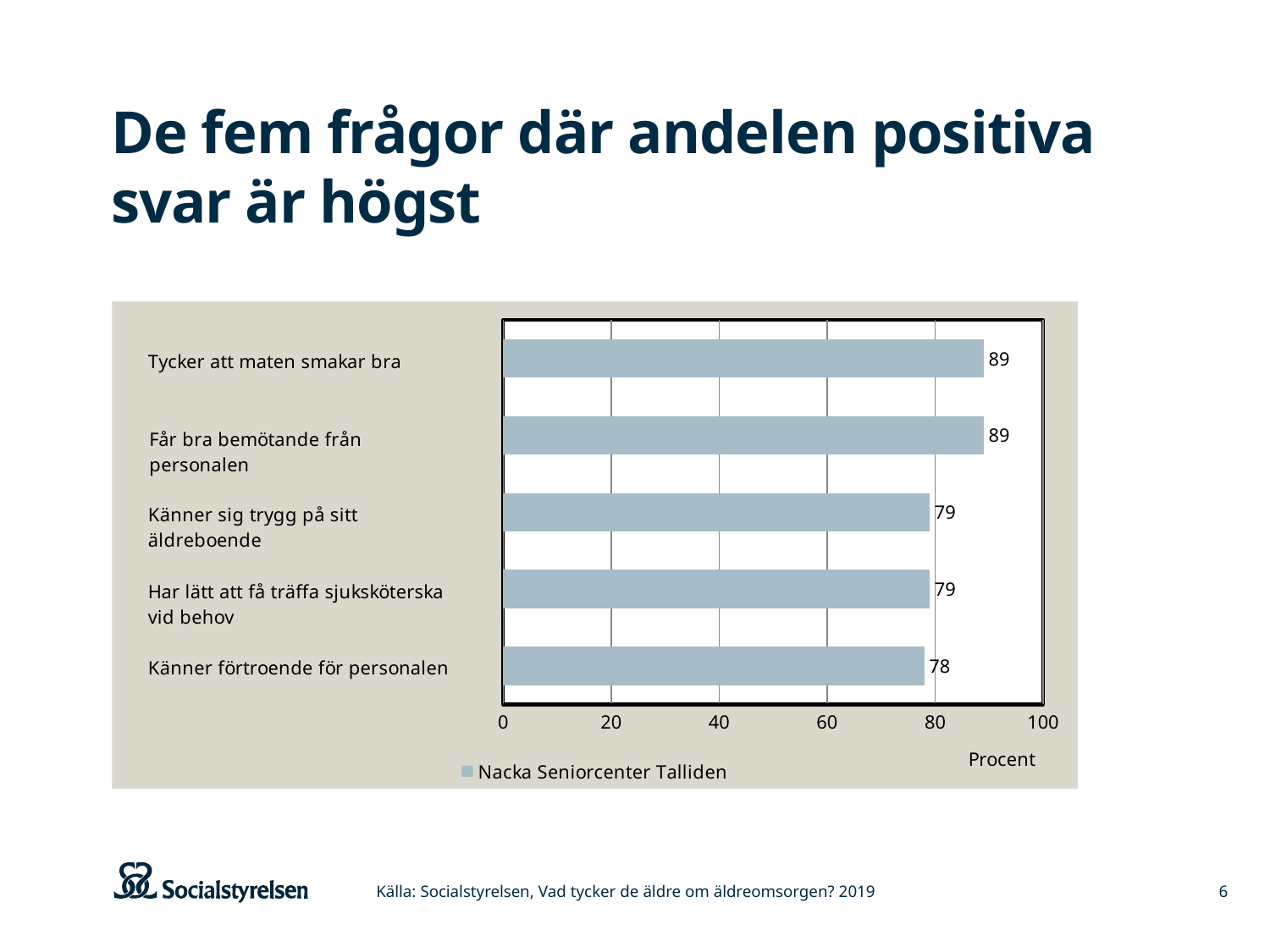
What series name is shown in the legend? Nacka Seniorcenter Talliden Which is larger: the value for "Tycker att maten smakar bra" or the value for "Känner sig trygg på sitt äldreboende"? Tycker att maten smakar bra How many categories are shown in the chart? 5 What is the value for "Känner sig trygg på sitt äldreboende"? 79 What is the value for "Har lätt att få träffa sjuksköterska vid behov"? 79 What is the value for "Tycker att maten smakar bra"? 89 What kind of chart is shown on the slide? bar chart Which category has the lowest value? Känner förtroende för personalen How many series does the legend list? 1 What is the difference between the values for "Får bra bemötande från personalen" and "Känner förtroende för personalen"? 11 What is the value for "Känner förtroende för personalen"? 78 Is the value for "Får bra bemötande från personalen" greater or less than 80? greater